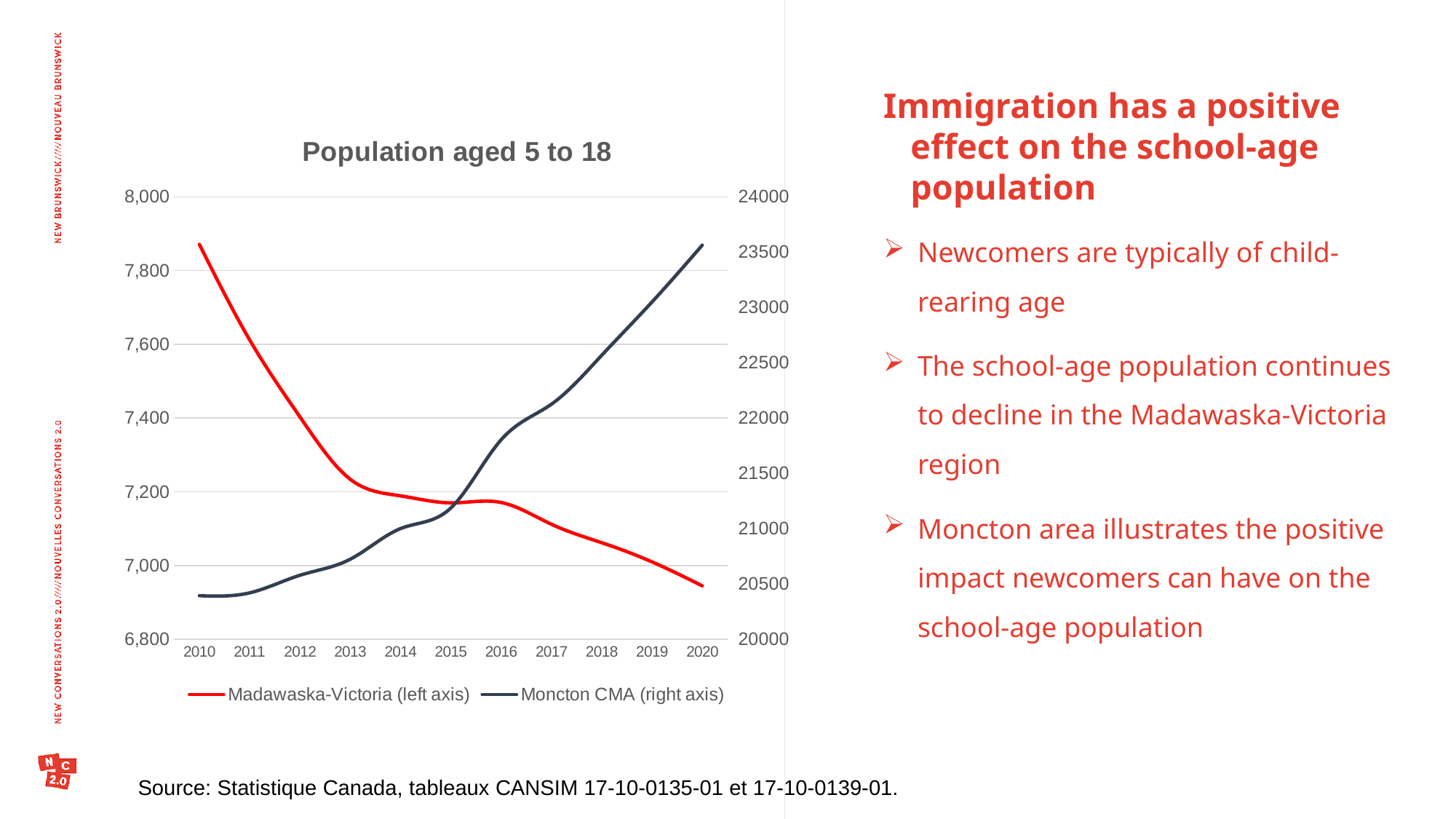
In which year is the Madawaska-Victoria population aged 5 to 18 highest? 2010 How many years are plotted along the x axis of the chart? 11 What kind of chart is shown on the slide? line chart In which year is the Moncton CMA population aged 5 to 18 highest? 2020 In which year is the Madawaska-Victoria population aged 5 to 18 lowest? 2020 Is the Moncton CMA value for 2020 greater or less than 23000? greater Does the Madawaska-Victoria line rise or fall from 2010 to 2020? fall Which colour is used for the Moncton CMA (right axis) line? dark grey What is the title of the chart? Population aged 5 to 18 Is the Madawaska-Victoria value for 2020 greater or less than 7,000? less How many series does the chart legend list? 2 Does the Moncton CMA line rise or fall from 2010 to 2020? rise